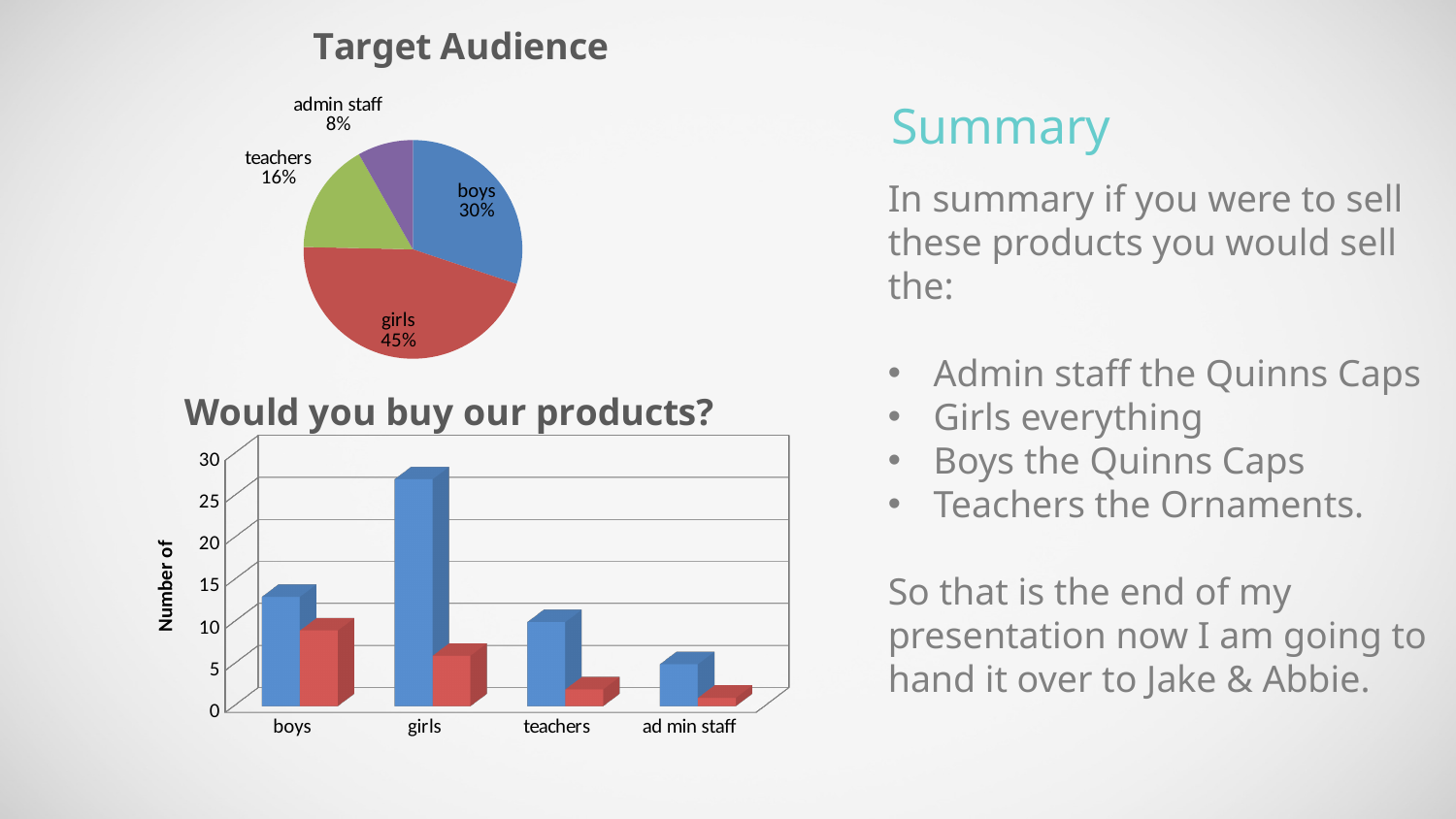
In the Target Audience pie chart, what is the difference between the shares for girls and boys? 15% In the Target Audience pie chart, which group has the largest share? girls What kind of chart is the Target Audience chart? pie chart In the 'Would you buy our products?' chart, which category has the tallest blue bar? girls How many slices does the Target Audience pie chart have? 4 In the 'Would you buy our products?' chart, is the blue bar for girls greater or less than 20? greater In the Target Audience pie chart, which is larger, the share for teachers or the share for boys? boys In the Target Audience pie chart, what share do girls make up? 45% What kind of chart is the 'Would you buy our products?' chart? bar chart In the Target Audience pie chart, what percentage is shown for admin staff? 8% How many categories are shown on the x axis of the 'Would you buy our products?' chart? 4 In the Target Audience pie chart, which group has the smallest share? admin staff